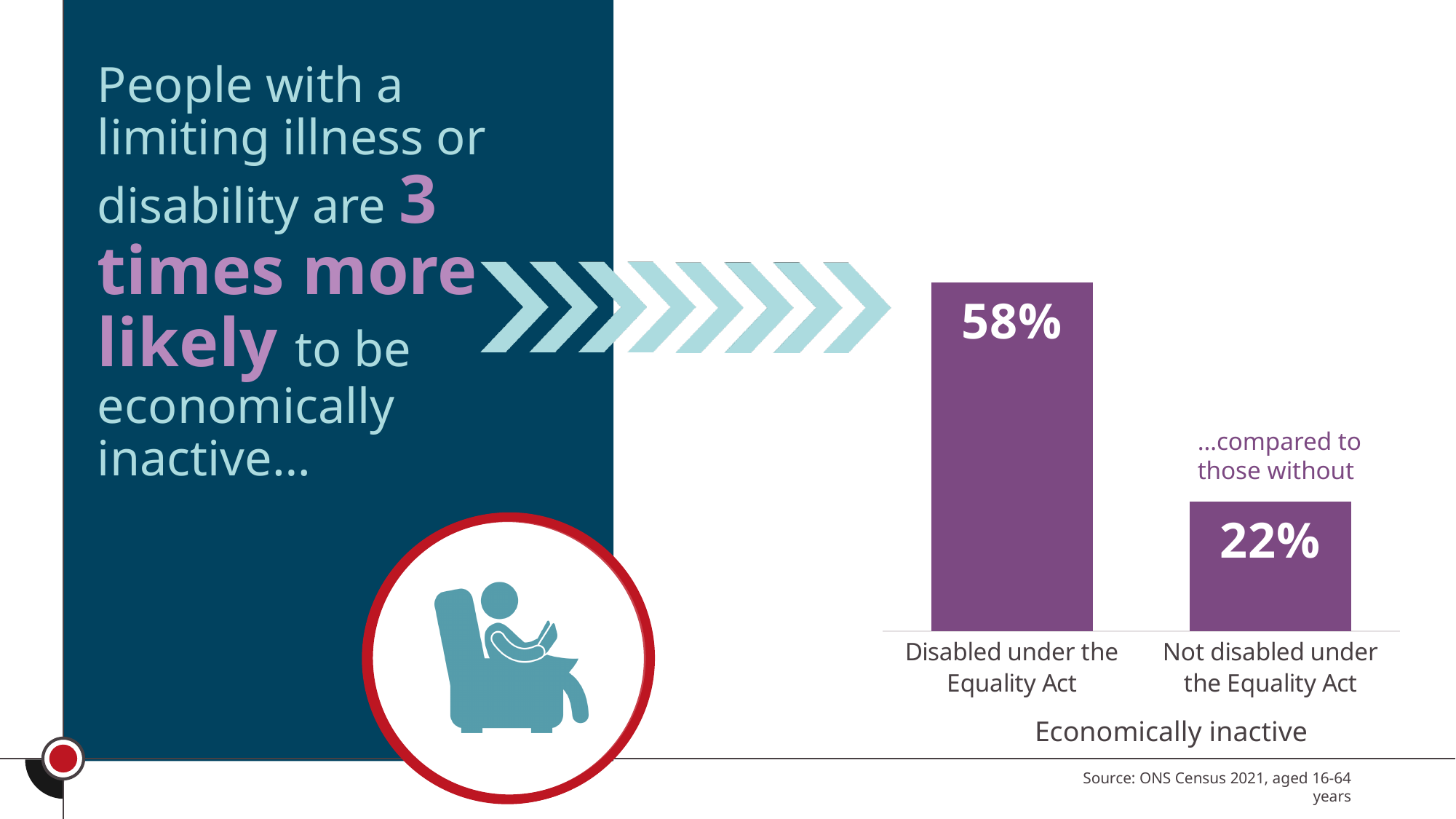
Which category has the lower economically inactive value? Not disabled under the Equality Act According to the slide text, how many times more likely are people with a limiting illness or disability to be economically inactive? 3 times What colour are the bars in the chart? purple How many categories are shown in the chart? 2 What kind of chart is shown on the slide? bar chart Is the value for 'Disabled under the Equality Act' larger or smaller than the value for 'Not disabled under the Equality Act'? larger What is the economically inactive value for people not disabled under the Equality Act? 22% Which category has the higher economically inactive value? Disabled under the Equality Act What is the label shown beneath the category axis of the chart? Economically inactive What is the difference in percentage points between the disabled and not disabled categories? 36 percentage points What is the economically inactive value for people disabled under the Equality Act? 58%